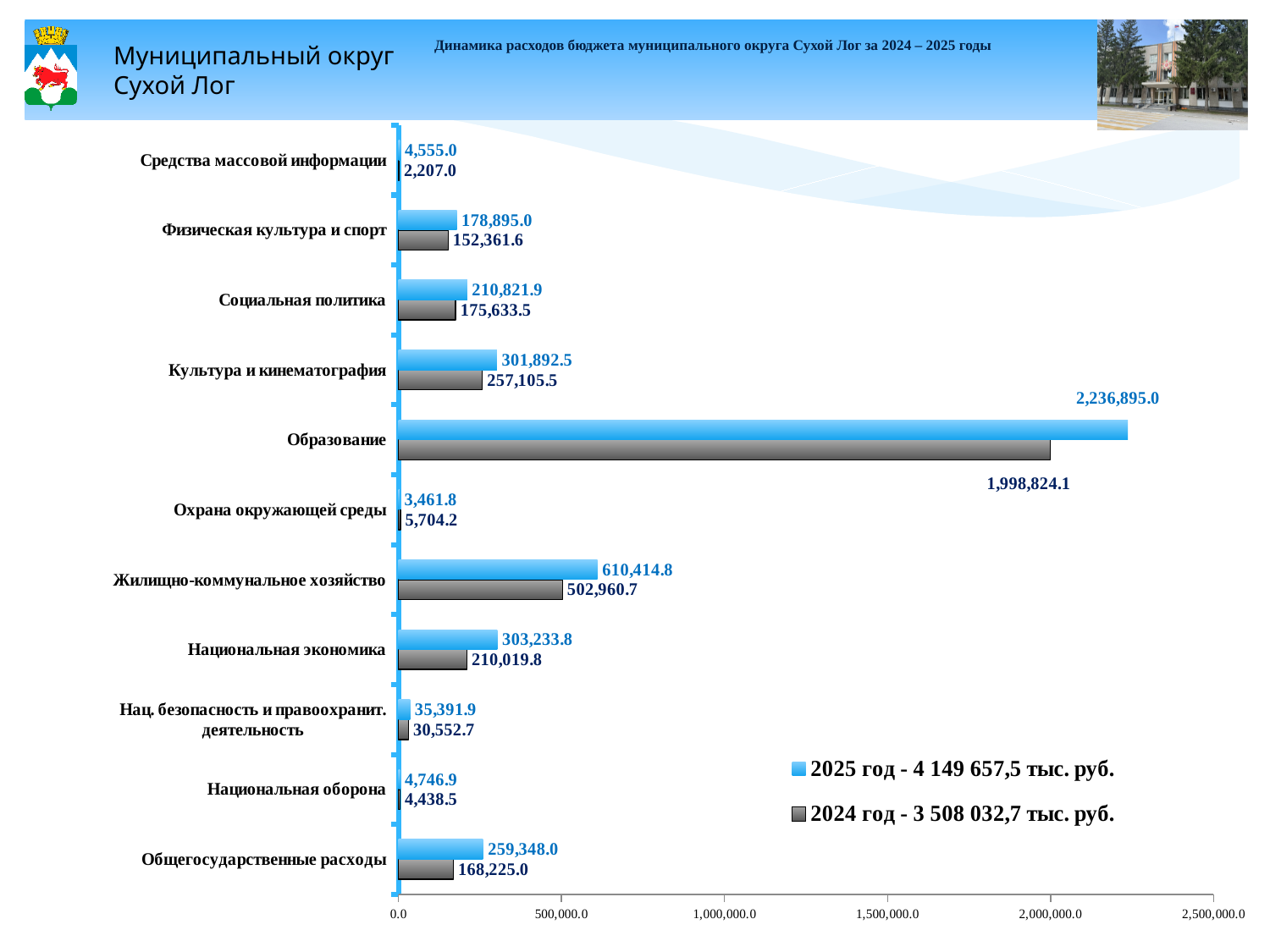
What is the difference between the 2025 and 2024 values for Образование? 238,070.9 What is the 2024 value for Жилищно-коммунальное хозяйство? 502,960.7 What is the 2025 value for Национальная экономика? 303,233.8 Which category has the lowest 2024 value? Средства массовой информации For Охрана окружающей среды, which is larger: the 2025 value or the 2024 value? 2024 Is the 2025 value for Жилищно-коммунальное хозяйство greater or less than 500,000.0? greater What is the 2025 value for Образование? 2,236,895.0 How many categories are shown on the chart? 11 How many series does the legend list? 2 What type of chart is shown on the slide? bar chart What total is shown in the legend for 2024 год? 3 508 032,7 тыс. руб. Which category has the highest 2025 value? Образование